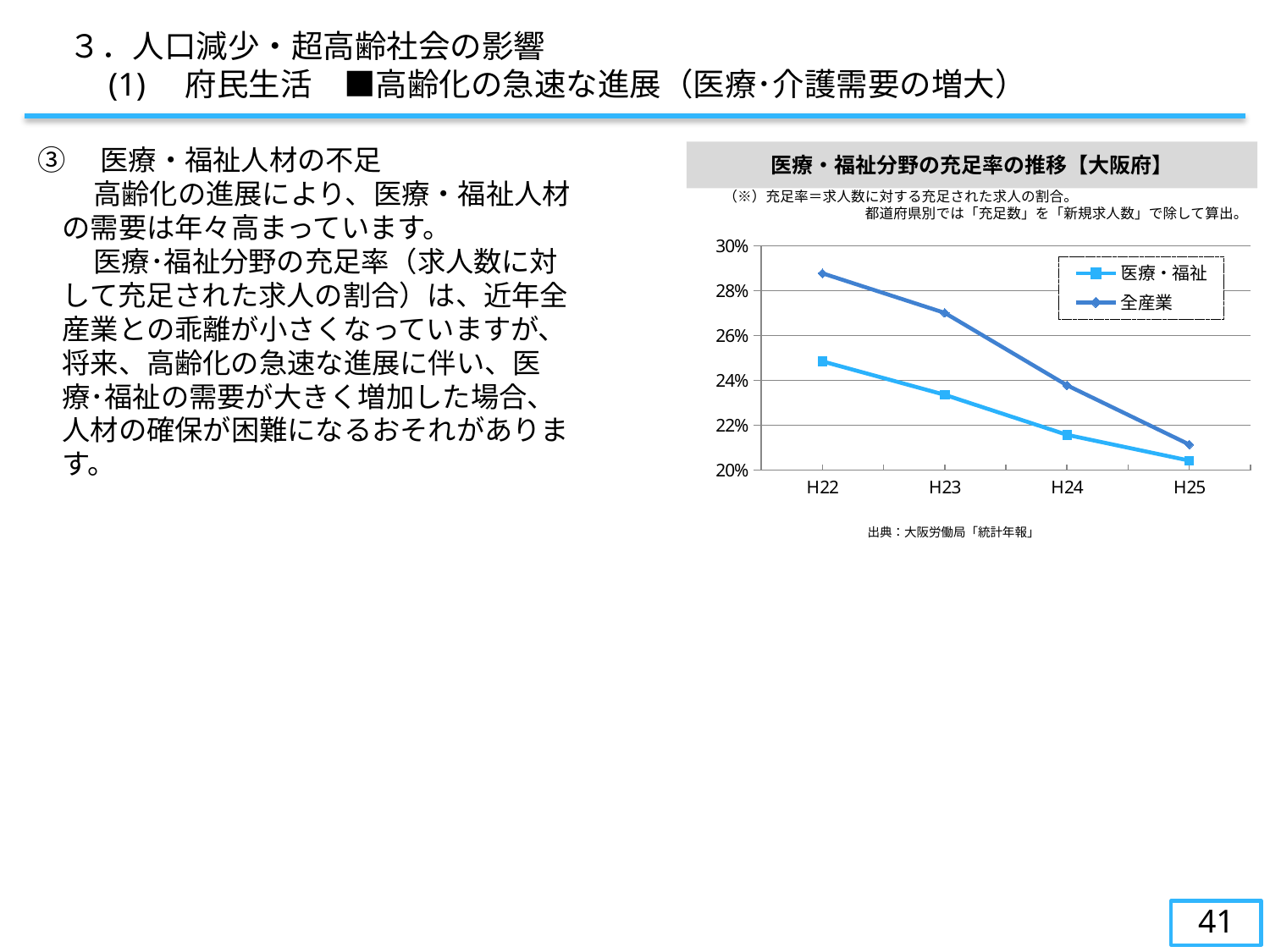
Is the value for 全産業 in H23 greater or less than 26%? greater What is the title of the chart? 医療・福祉分野の充足率の推移【大阪府】 Is the value for 医療・福祉 in H22 greater or less than 26%? less How many series does the legend list? 2 Does the 全産業 line rise or fall from H22 to H25? Fall Does the 医療・福祉 line rise or fall from H22 to H25? Fall What kind of chart is shown on the slide? Line chart In H24, which series has the higher value, 医療・福祉 or 全産業? 全産業 In which year is the 全産業 value highest? H22 Is the value for 医療・福祉 in H24 greater or less than 22%? less How many years are plotted along the x axis? 4